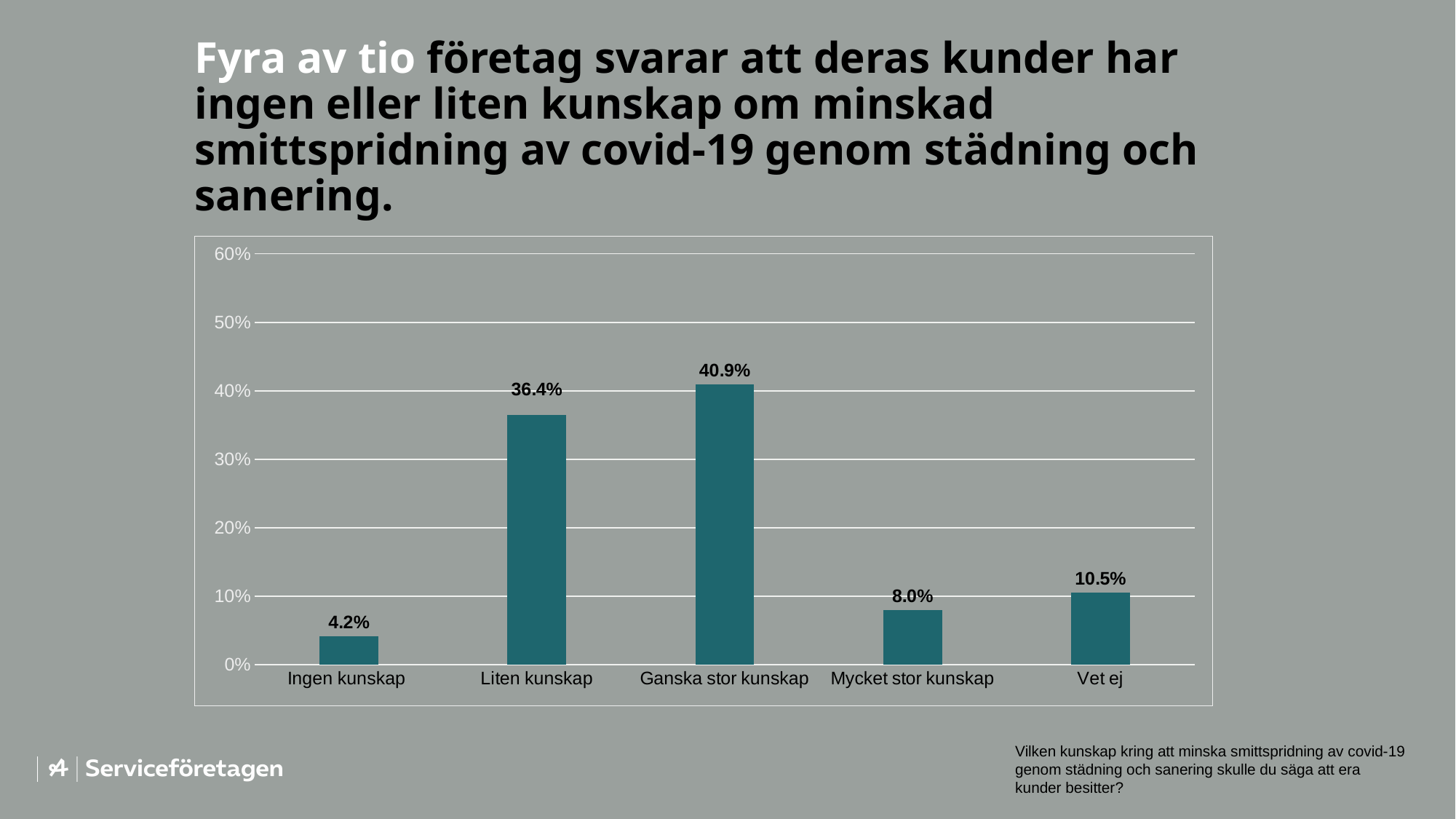
What is the value for Vet ej? 10.5% Which category has the highest value? Ganska stor kunskap Which category has the lowest value? Ingen kunskap What is the difference between the values for Ganska stor kunskap and Liten kunskap? 4.5% What is the value for Mycket stor kunskap? 8.0% Which is larger, the value for Vet ej or the value for Mycket stor kunskap? Vet ej What is the value for Ganska stor kunskap? 40.9% How many categories are shown on the x axis? 5 What is the value for Ingen kunskap? 4.2% Is the value for Liten kunskap greater or less than 30%? greater What kind of chart is shown on the slide? Bar chart What is the value for Liten kunskap? 36.4%